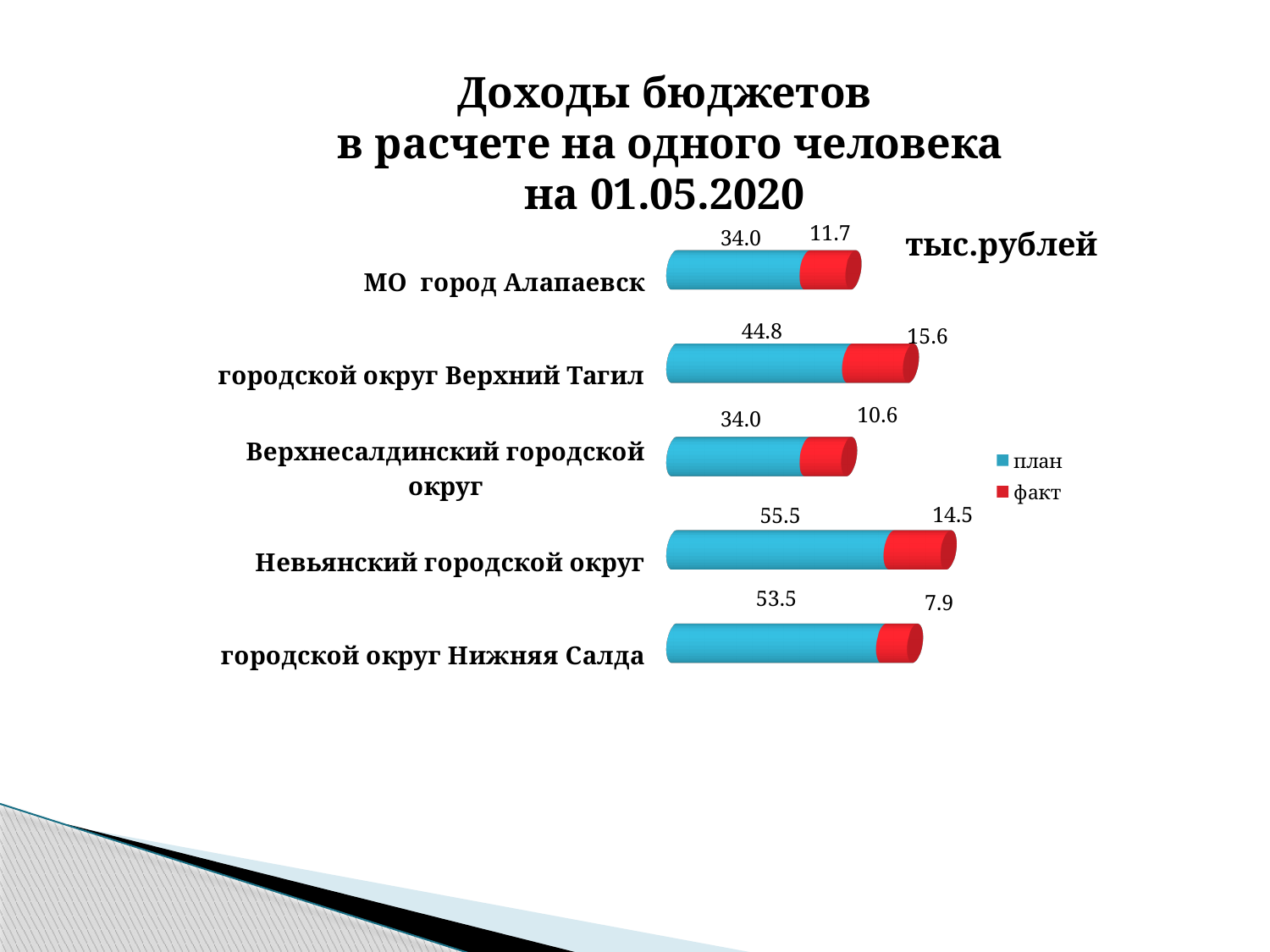
What is the total of the stacked bar for городской округ Верхний Тагил? 60.4 What is the факт value for городской округ Верхний Тагил? 15.6 Which category has the lowest факт value? городской округ Нижняя Салда What kind of chart is shown on the slide? Bar chart Which category has the highest факт value? городской округ Верхний Тагил How many series does the legend list? 2 Which has the larger факт value: МО город Алапаевск or Верхнесалдинский городской округ? МО город Алапаевск What is the difference between the план and факт values for городской округ Нижняя Салда? 45.6 What is the факт value for городской округ Нижняя Салда? 7.9 How many categories are shown in the chart? 5 Which category has the highest план value? Невьянский городской округ What is the план value for Невьянский городской округ? 55.5